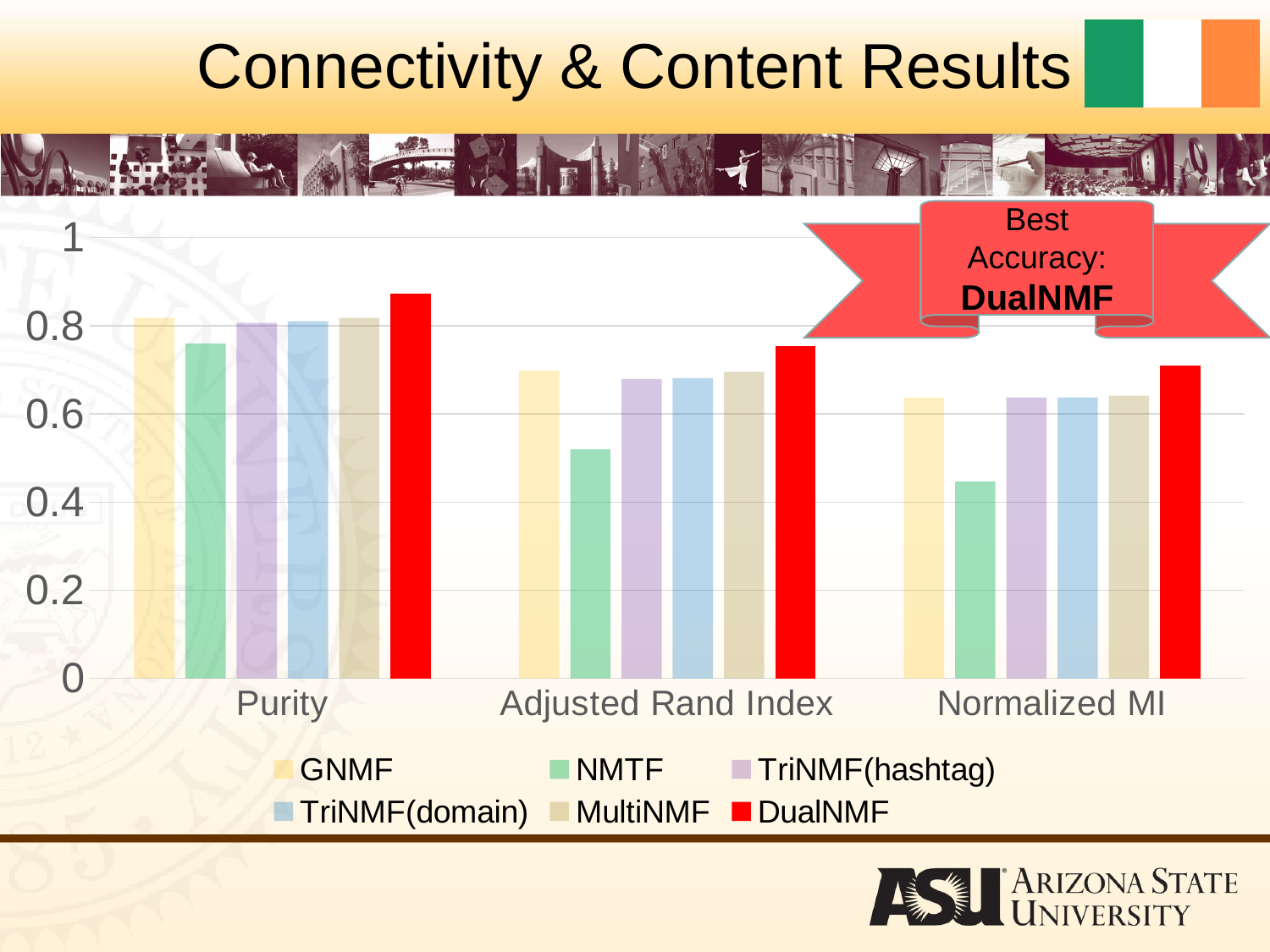
How many categories are shown along the x axis of the chart? 3 For Adjusted Rand Index, which is larger: the value for DualNMF or the value for NMTF? DualNMF What kind of chart is shown on the slide? bar chart How many series does the chart's legend list? 6 Which method has the highest bar for Normalized MI? DualNMF Which method has the lowest bar for Adjusted Rand Index? NMTF Is the value for NMTF on Adjusted Rand Index greater or less than 0.6? less Which method has the lowest bar for Normalized MI? NMTF Is the value for DualNMF on Purity greater or less than 0.8? greater Is the value for NMTF on Normalized MI greater or less than 0.6? less Which method has the highest bar for Purity? DualNMF Which series is drawn in red in the chart? DualNMF